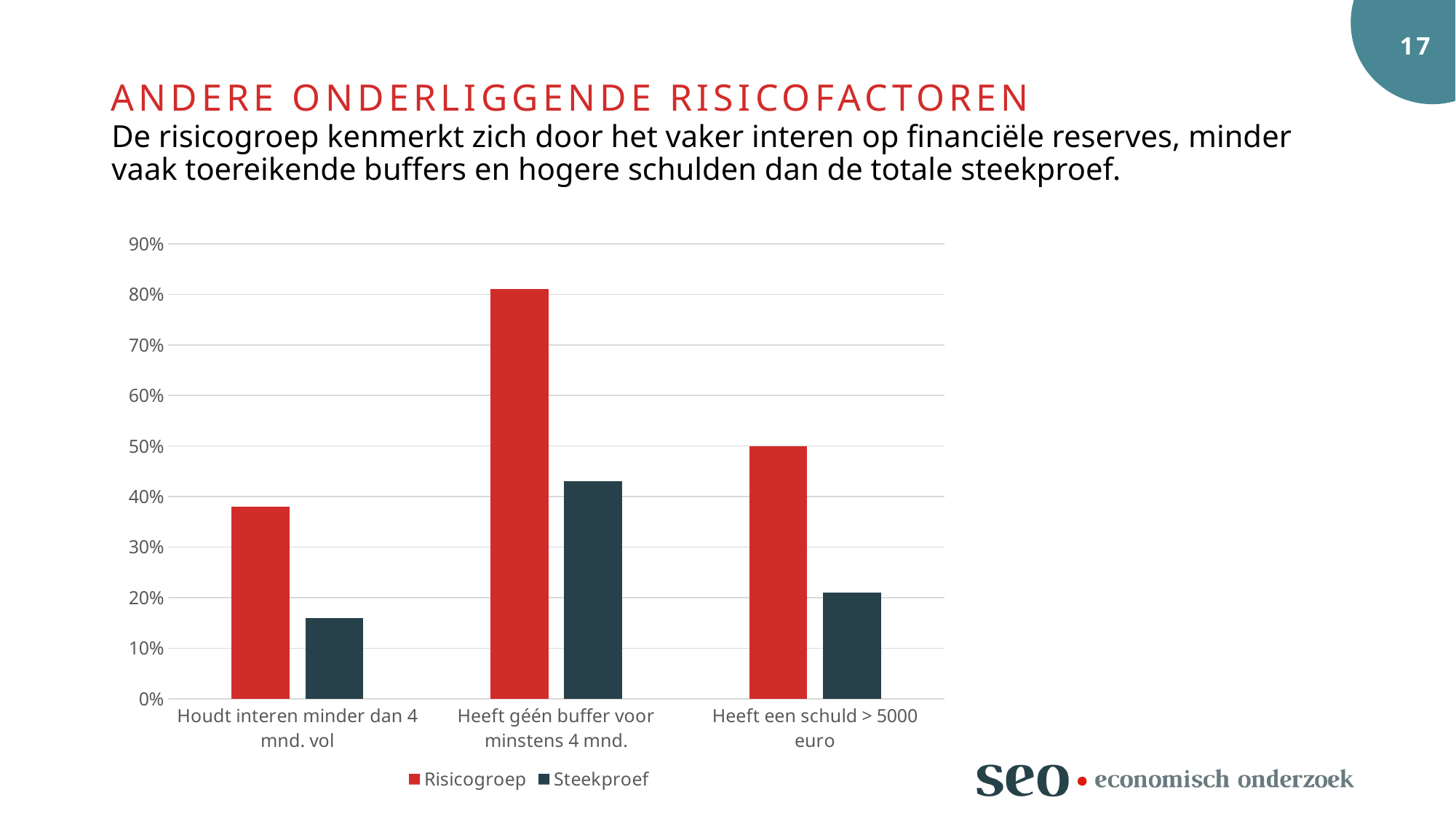
How many series does the legend list? 2 For 'Heeft een schuld > 5000 euro', which series has the larger value, Risicogroep or Steekproef? Risicogroep Which category has the highest value for Risicogroep? Heeft géén buffer voor minstens 4 mnd. What is the highest value shown on the y axis of the chart? 90% Which series is shown in red in the chart? Risicogroep Is the Steekproef value for 'Heeft géén buffer voor minstens 4 mnd.' greater or less than 40%? greater What kind of chart is shown on the slide? bar chart Which category has the lowest value for Risicogroep? Houdt interen minder dan 4 mnd. vol Which category has the lowest value for Steekproef? Houdt interen minder dan 4 mnd. vol Is the Steekproef value for 'Houdt interen minder dan 4 mnd. vol' greater or less than 20%? less Is the Risicogroep value for 'Heeft géén buffer voor minstens 4 mnd.' greater or less than 70%? greater How many categories are shown on the x axis of the chart? 3